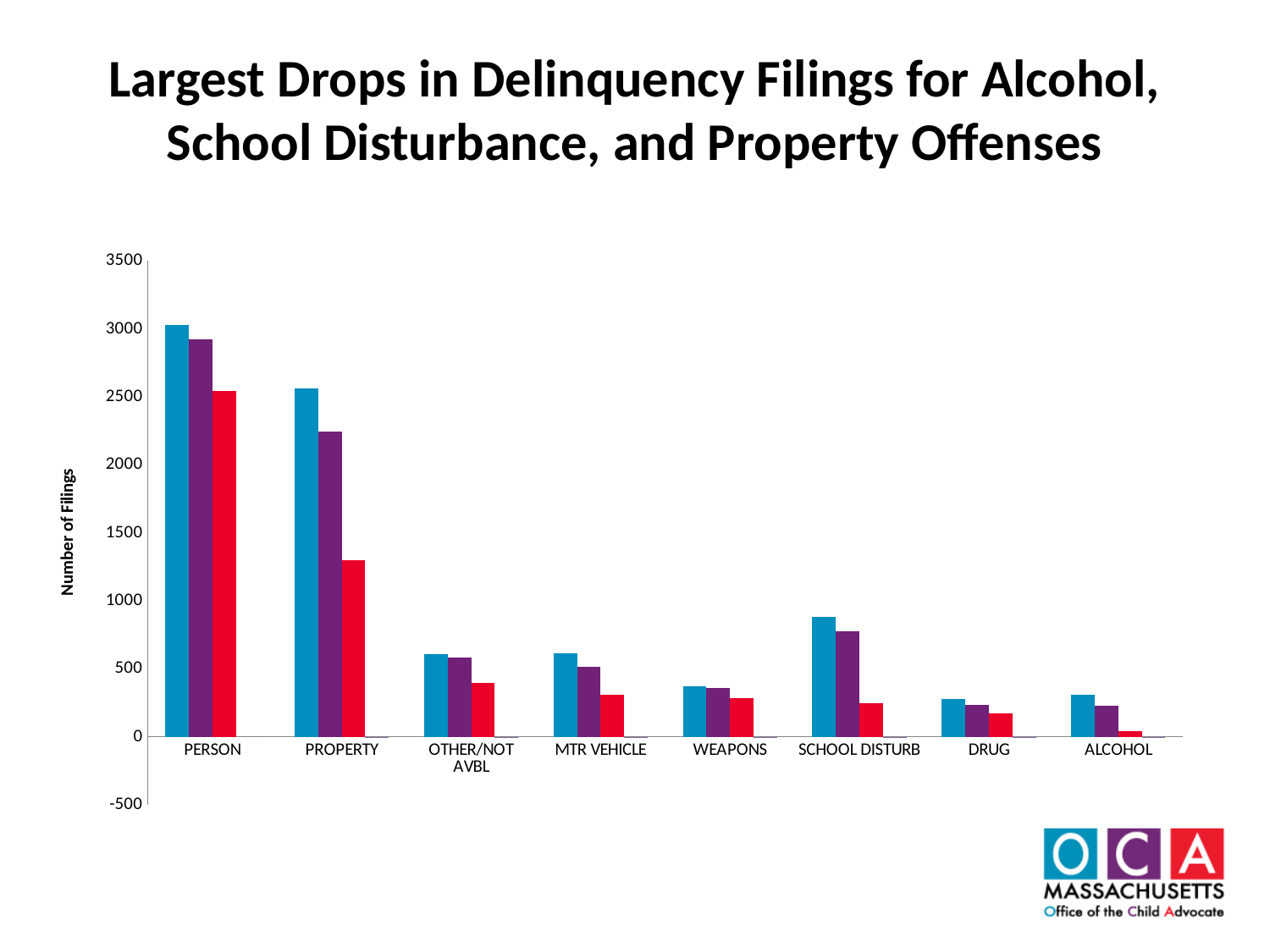
Within each category, do the bars rise or fall from the blue bar to the red bar? fall What kind of chart is shown on the slide? bar chart What is the label on the vertical axis? Number of Filings Is the blue bar for SCHOOL DISTURB greater or less than 1000? less Is the red bar for PERSON greater or less than 2000? greater Is the red bar for PROPERTY greater or less than 1500? less Which has a taller blue bar, PROPERTY or SCHOOL DISTURB? PROPERTY Which category has the shortest red bar? ALCOHOL Which category has the tallest bars? PERSON How many bars are shown for each category? 3 How many offense categories are shown on the x axis? 8